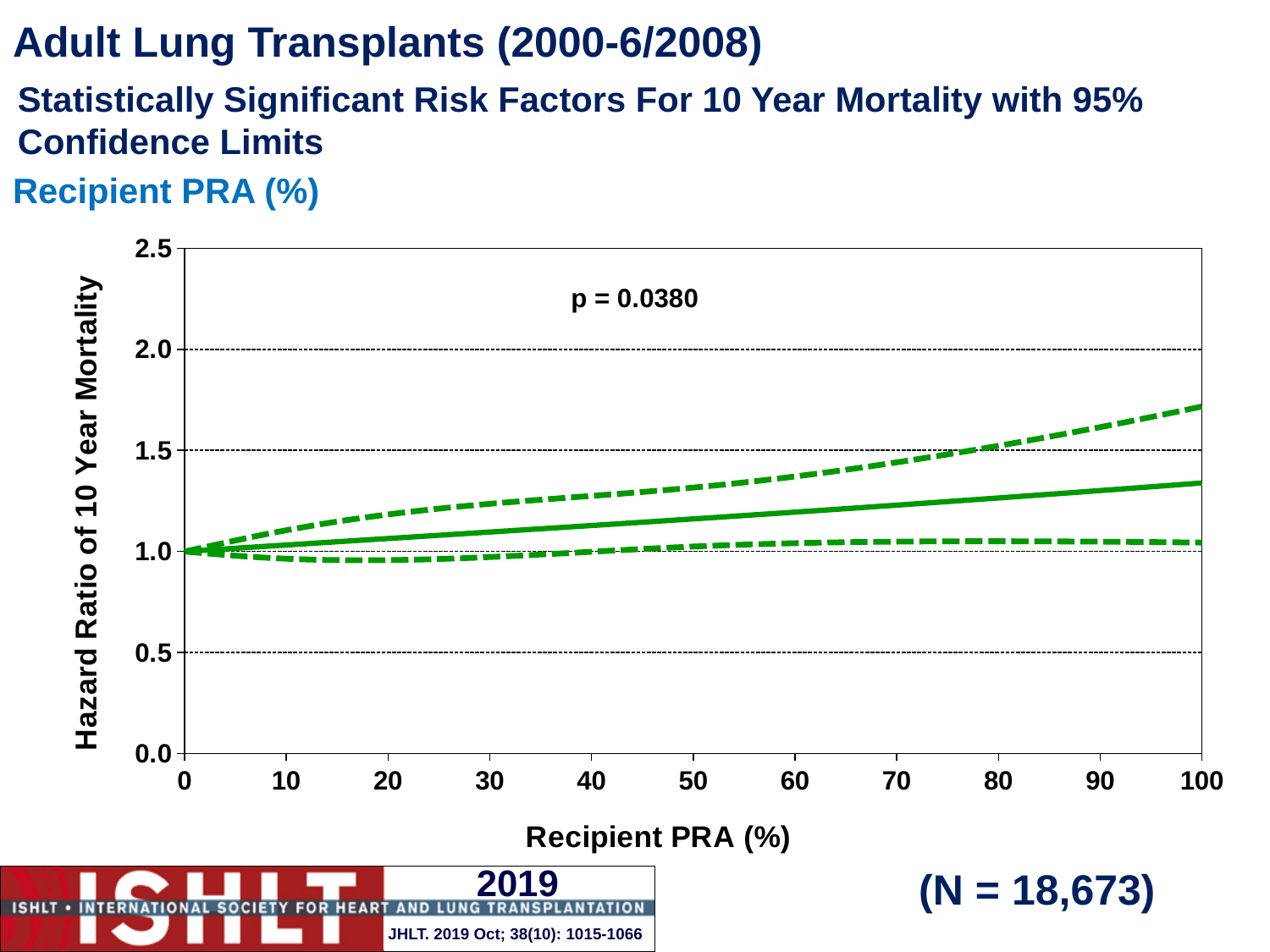
Is the lower dashed confidence limit at Recipient PRA 20% greater or less than 1.0? less Does the solid hazard ratio line rise or fall as Recipient PRA (%) increases from 0 to 100? rise Is the hazard ratio of the solid line at Recipient PRA 100% greater or less than 1.0? greater How many lines are plotted on the chart? 3 What p-value is printed on the chart? p = 0.0380 What kind of chart is shown on the slide? line chart What is the highest tick value shown on the y axis? 2.5 What is the label of the y axis? Hazard Ratio of 10 Year Mortality Is the upper dashed confidence limit at Recipient PRA 100% greater or less than 2.0? less What is the hazard ratio of the solid line at Recipient PRA 0%? 1.0